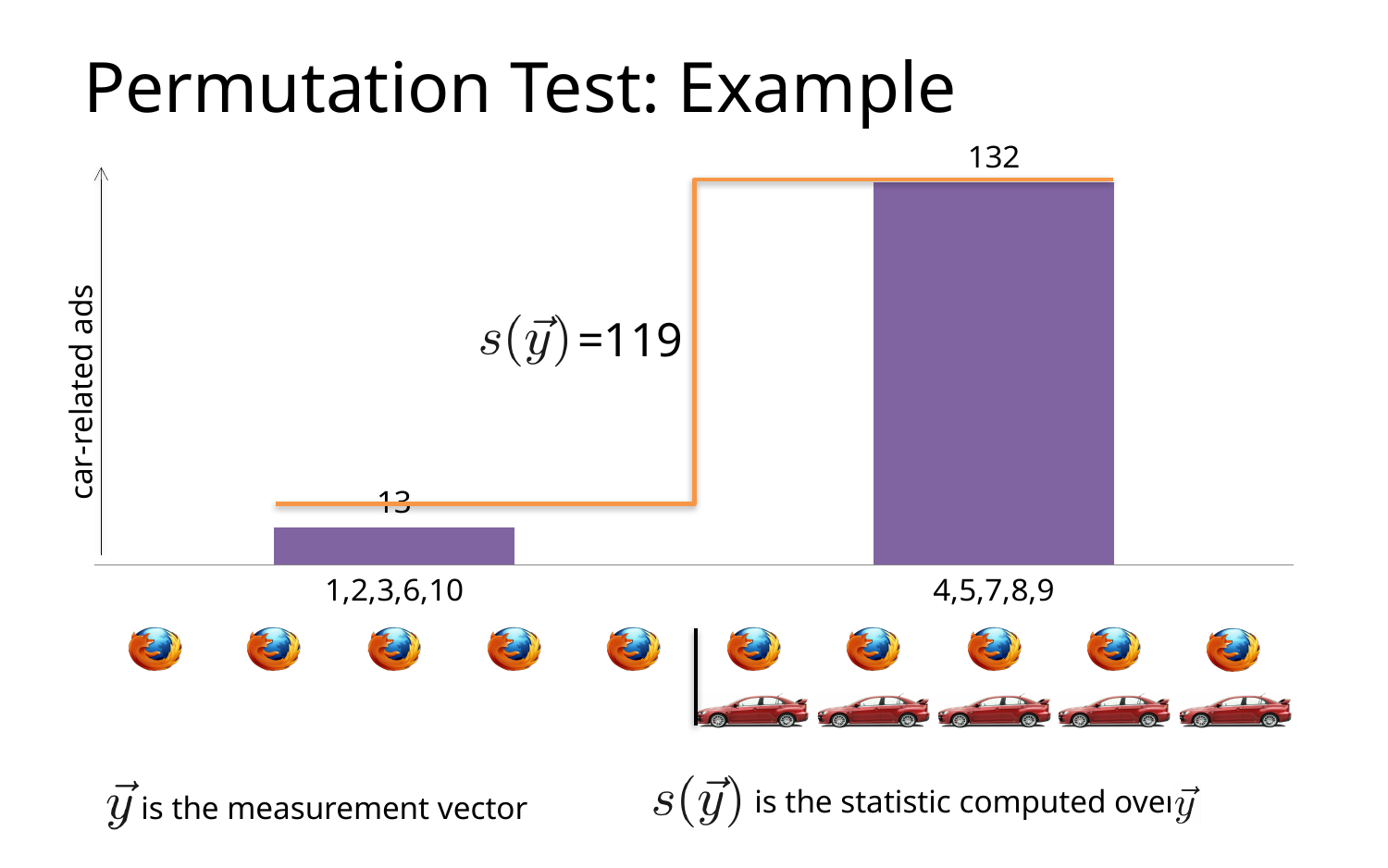
What value of the statistic s(y) is written on the chart? 119 Which bar is larger, 1,2,3,6,10 or 4,5,7,8,9? 4,5,7,8,9 What is the value of the bar labelled 1,2,3,6,10? 13 Which category has the highest bar? 4,5,7,8,9 What is the value of the bar labelled 4,5,7,8,9? 132 Do the bar values rise or fall from left to right along the x axis? rise What is the label on the vertical axis of the chart? car-related ads How many bars are plotted in the chart? 2 Which category has the lowest bar? 1,2,3,6,10 What is the difference between the bar for 4,5,7,8,9 and the bar for 1,2,3,6,10? 119 What kind of chart is shown on the slide? bar chart